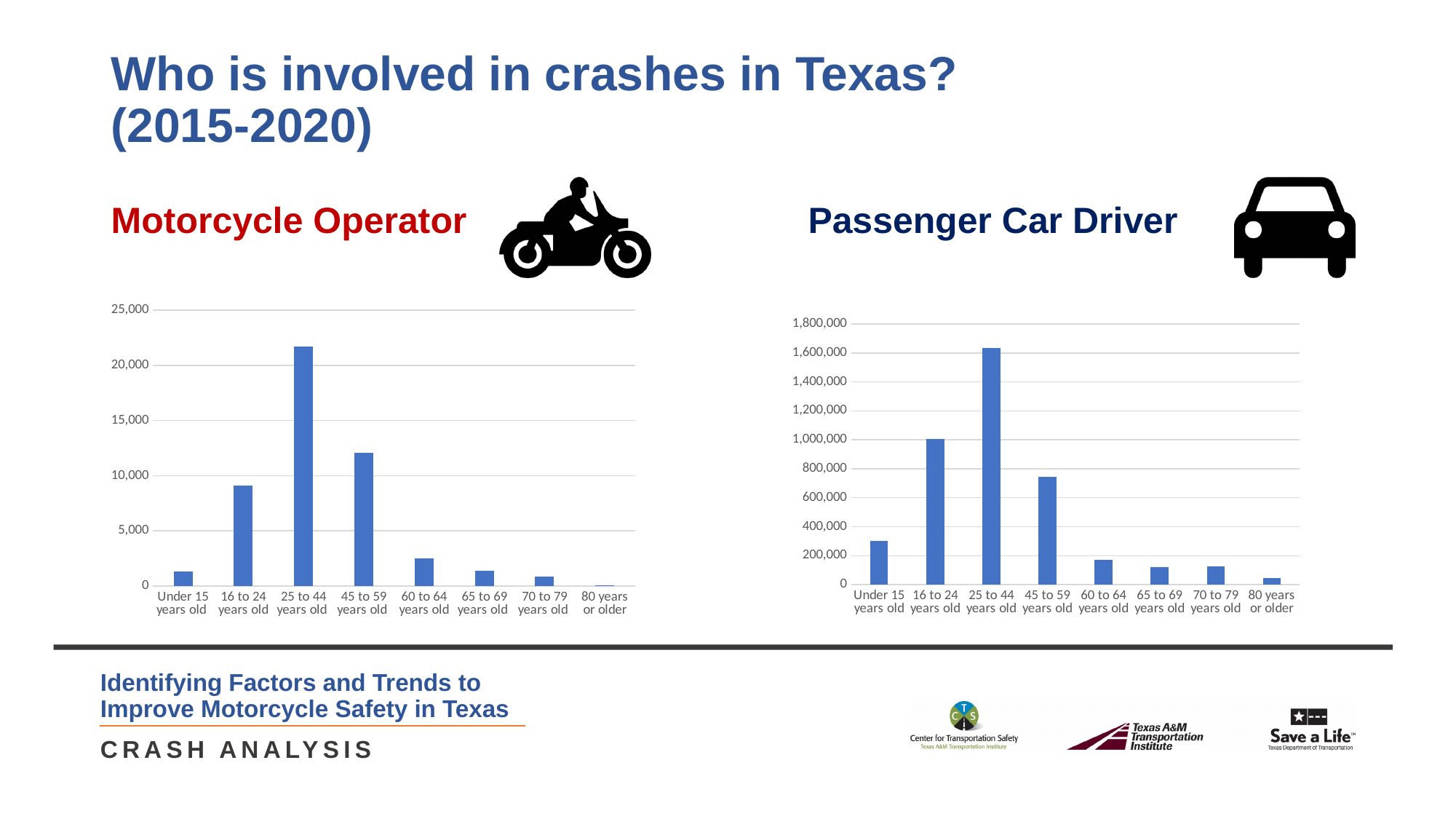
On the Motorcycle Operator chart, is the value for 25 to 44 years old greater or less than 20,000? greater On the Passenger Car Driver chart, which is larger: the value for Under 15 years old or the value for 60 to 64 years old? Under 15 years old On the Motorcycle Operator chart, which age group has the lowest value? 80 years or older On the Passenger Car Driver chart, which age group has the lowest value? 80 years or older On the Passenger Car Driver chart, is the value for 45 to 59 years old greater or less than 800,000? less On the Motorcycle Operator chart, which age group has the highest value? 25 to 44 years old What kind of chart is the Motorcycle Operator chart? bar chart On the Motorcycle Operator chart, which is larger: the value for 16 to 24 years old or the value for 45 to 59 years old? 45 to 59 years old On the Passenger Car Driver chart, is the value for 25 to 44 years old greater or less than 1,400,000? greater How many age categories are shown on the Passenger Car Driver chart? 8 On the Passenger Car Driver chart, which age group has the highest value? 25 to 44 years old